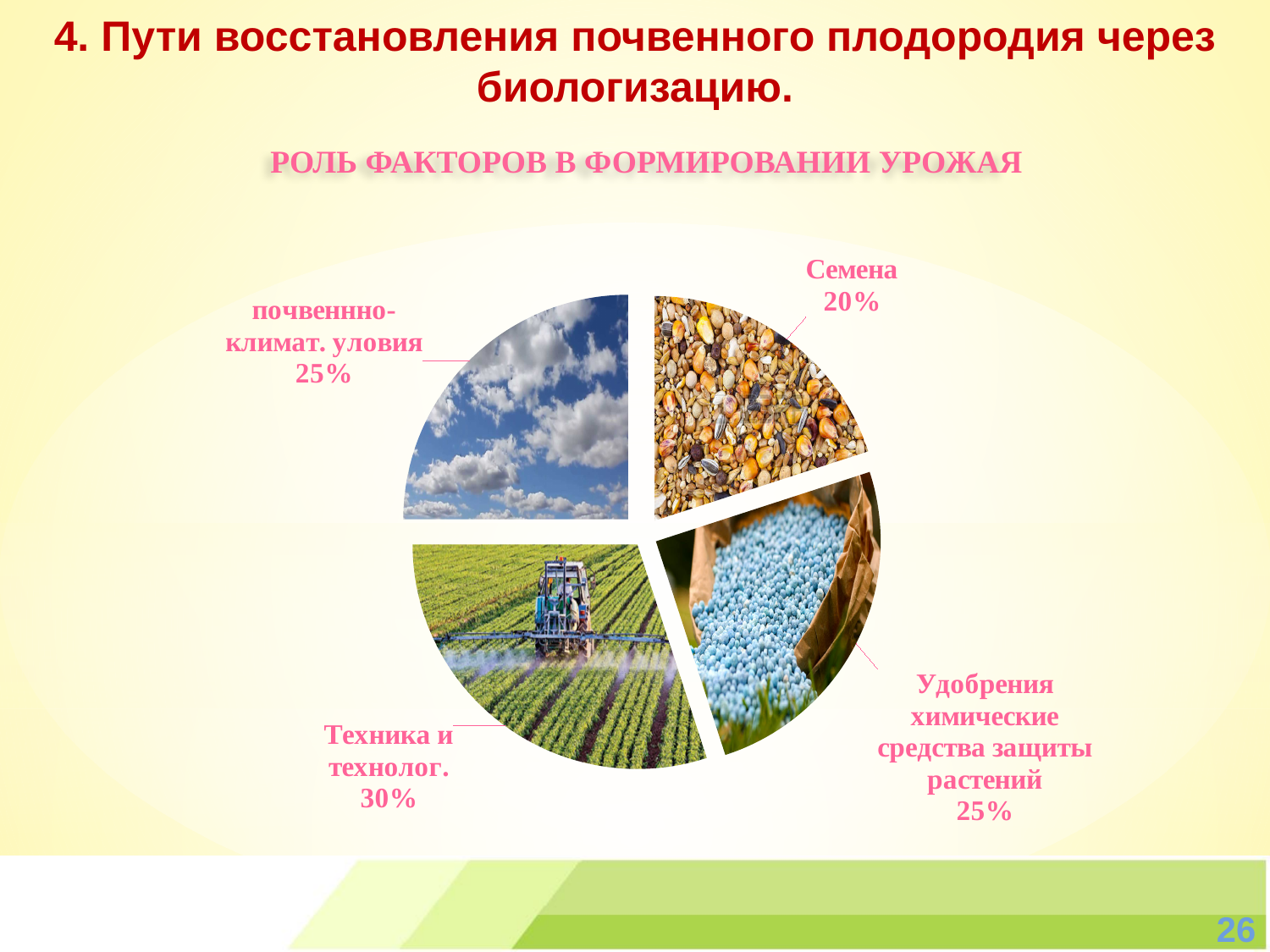
Which factor has the largest share of the pie? Техника и технолог. What share of the pie is labelled "почвеннно-климат. уловия"? 25% What is the title of the chart? РОЛЬ ФАКТОРОВ В ФОРМИРОВАНИИ УРОЖАЯ Which factor has the smallest share of the pie? Семена What is the difference between the share for "Техника и технолог." and the share for "Семена"? 10% What share of the pie is labelled "Семена"? 20% What kind of chart is shown on the slide? pie chart What is the combined share of "почвеннно-климат. уловия" and "Удобрения химические средства защиты растений"? 50% How many slices does the pie chart have? 4 What share of the pie is labelled "Удобрения химические средства защиты растений"? 25% Which is larger: the share for "Техника и технолог." or the share for "Семена"? Техника и технолог.